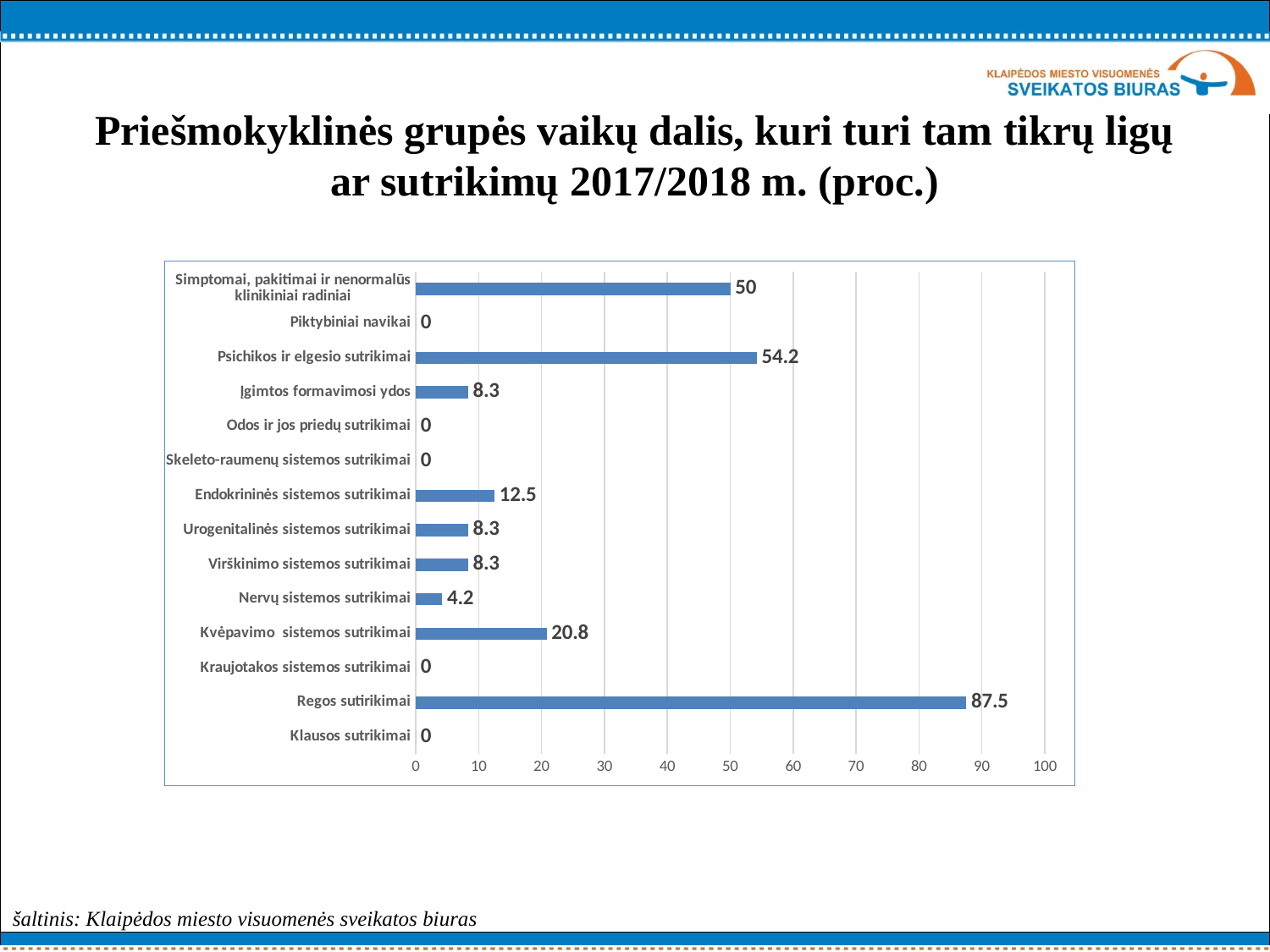
What is the value for Nervų sistemos sutrikimai? 4.2 What type of chart is shown on the slide? bar chart How many categories are shown in the chart? 14 What is the value for Endokrininės sistemos sutrikimai? 12.5 How many categories have a value of 0? 5 Which category has the highest value? Regos sutirikimai Which is larger: the value for Simptomai, pakitimai ir nenormalūs klinikiniai radiniai or the value for Psichikos ir elgesio sutrikimai? Psichikos ir elgesio sutrikimai What is the value for Kvėpavimo sistemos sutrikimai? 20.8 What is the maximum value shown on the horizontal axis? 100 What is the difference between the values for Regos sutirikimai and Psichikos ir elgesio sutrikimai? 33.3 What is the value for Psichikos ir elgesio sutrikimai? 54.2 What is the value for Regos sutirikimai? 87.5